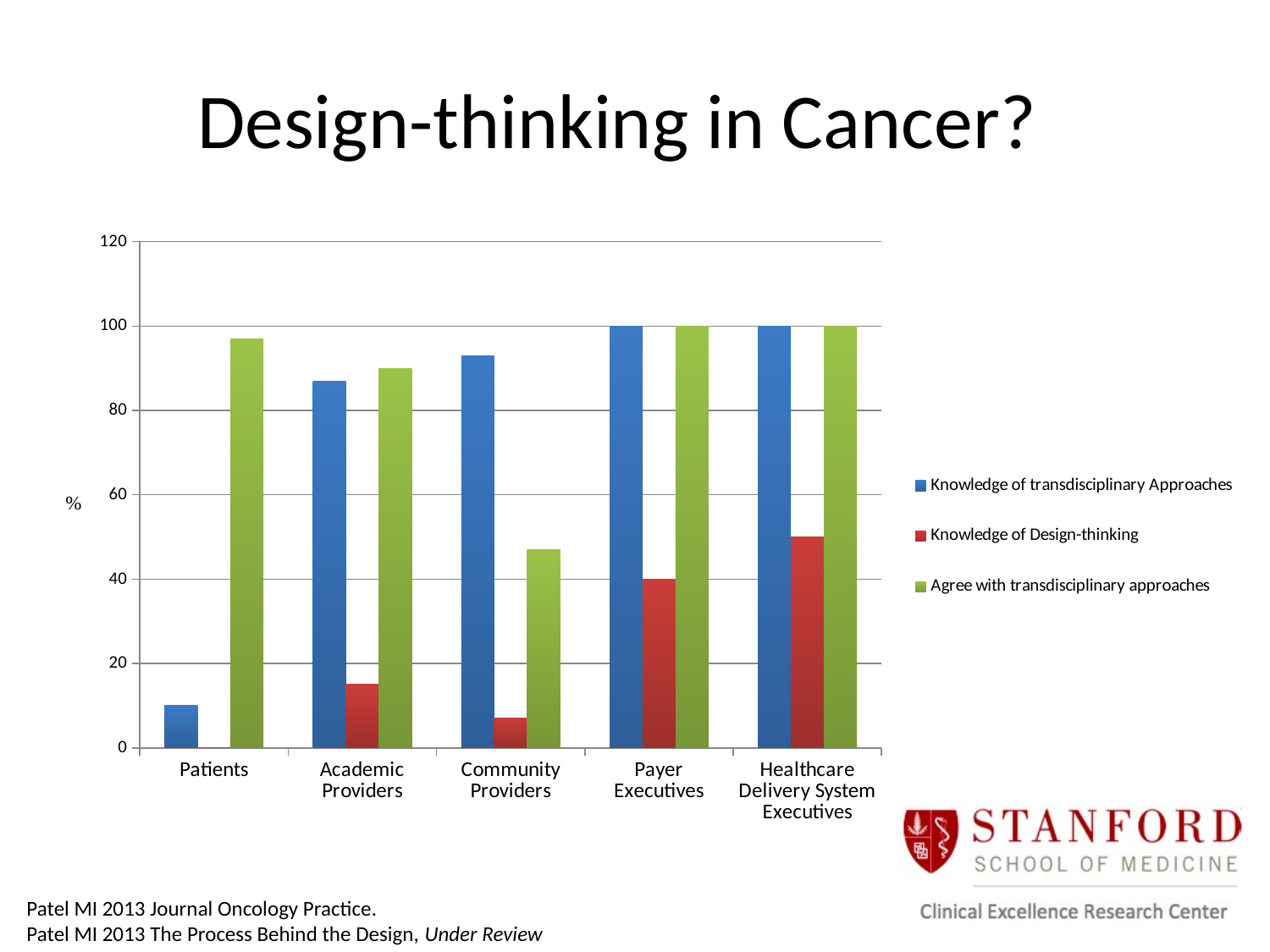
In the Agree with transdisciplinary approaches series, which is larger: Academic Providers or Community Providers? Academic Providers How many categories are shown on the x axis? 5 What kind of chart is shown on the slide? bar chart Is the value for Patients in the Agree with transdisciplinary approaches series greater or less than 80? greater How many series does the legend list? 3 Which category has the highest value in the Knowledge of Design-thinking series? Healthcare Delivery System Executives What is the value for Healthcare Delivery System Executives in the Agree with transdisciplinary approaches series? 100 What is the value for Payer Executives in the Knowledge of transdisciplinary Approaches series? 100 Is the value for Patients in the Knowledge of transdisciplinary Approaches series greater or less than 20? less Is the value for Community Providers in the Knowledge of Design-thinking series greater or less than 20? less Which category has the lowest value in the Knowledge of transdisciplinary Approaches series? Patients